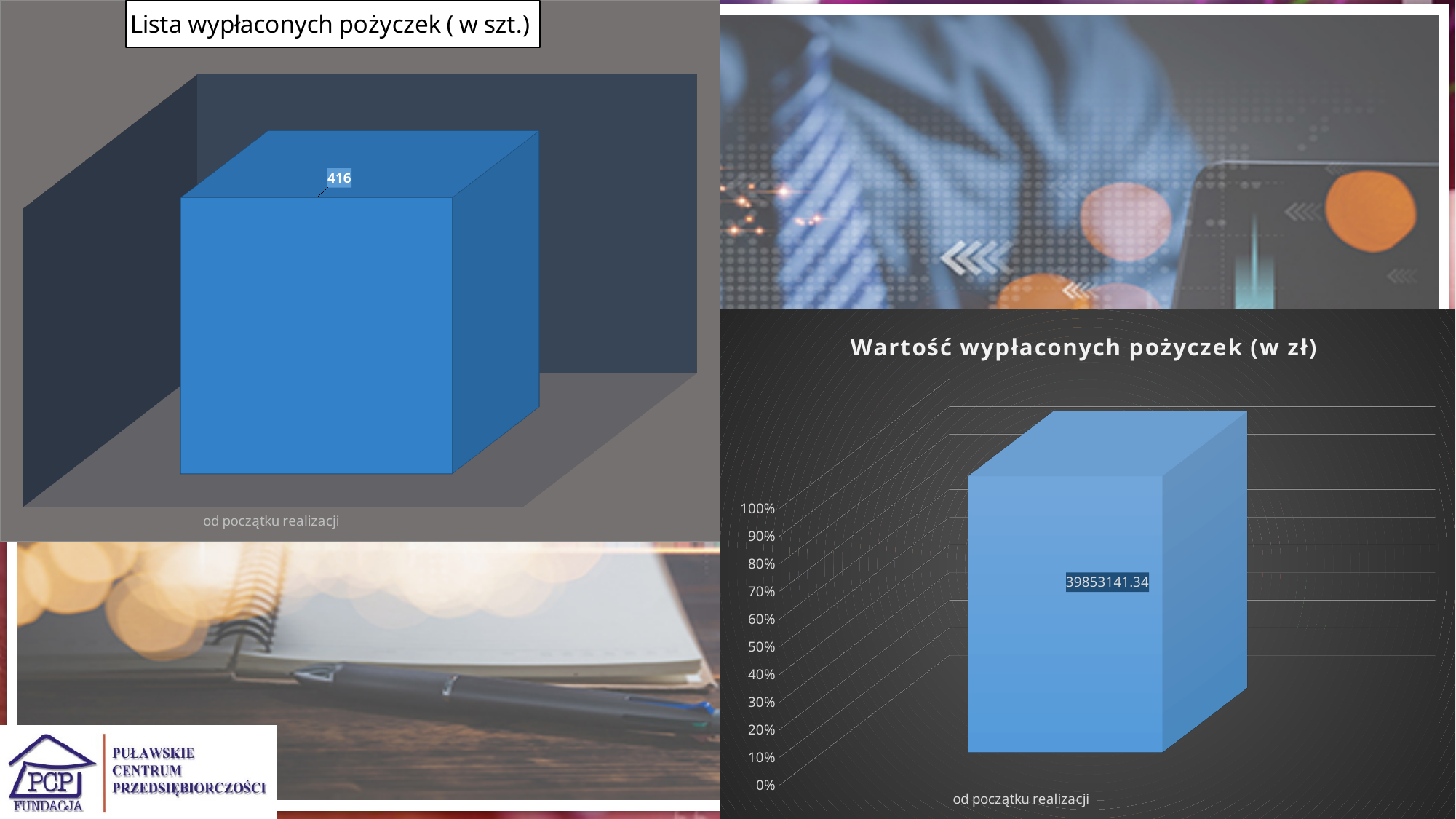
What is the title of the chart on the right side of the slide? Wartość wypłaconych pożyczek (w zł) What kind of chart is the one titled "Wartość wypłaconych pożyczek (w zł)"? bar chart How many bars are plotted in the chart titled "Lista wypłaconych pożyczek ( w szt.)"? 1 In the chart titled "Lista wypłaconych pożyczek ( w szt.)", what value is shown for "od początku realizacji"? 416 In the chart titled "Wartość wypłaconych pożyczek (w zł)", what is the highest tick label shown on the vertical axis? 100% In the chart titled "Wartość wypłaconych pożyczek (w zł)", what value is shown for "od początku realizacji"? 39853141.34 How many bars are plotted in the chart titled "Wartość wypłaconych pożyczek (w zł)"? 1 What is the category label on the x axis of the chart titled "Lista wypłaconych pożyczek ( w szt.)"? od początku realizacji What kind of chart is the one titled "Lista wypłaconych pożyczek ( w szt.)"? bar chart